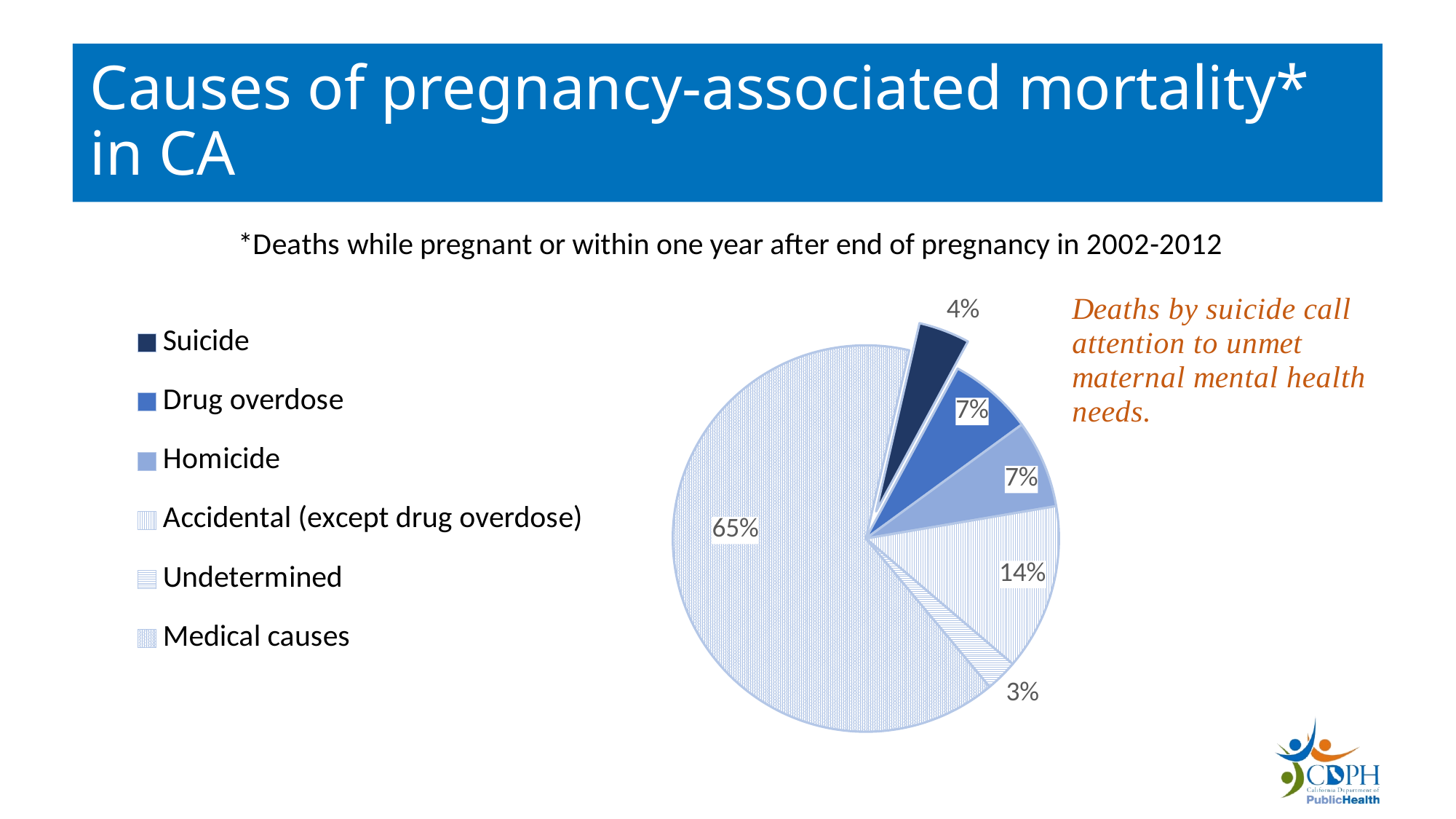
What share of pregnancy-associated deaths is attributed to Drug overdose? 7% Which is larger, the share for Homicide or the share for Undetermined? Homicide Which slice of the pie is pulled out (exploded) from the rest? Suicide What kind of chart is shown on the slide? pie chart Which cause accounts for the largest share of the pie? Medical causes What share of pregnancy-associated deaths is attributed to Accidental (except drug overdose)? 14% Which cause accounts for the smallest share of the pie? Undetermined How many categories does the legend list? 6 What share of pregnancy-associated deaths is attributed to Undetermined? 3% What is the difference in percentage points between Accidental (except drug overdose) and Suicide? 10 What share of pregnancy-associated deaths is attributed to Suicide? 4% What share of pregnancy-associated deaths is attributed to Medical causes? 65%